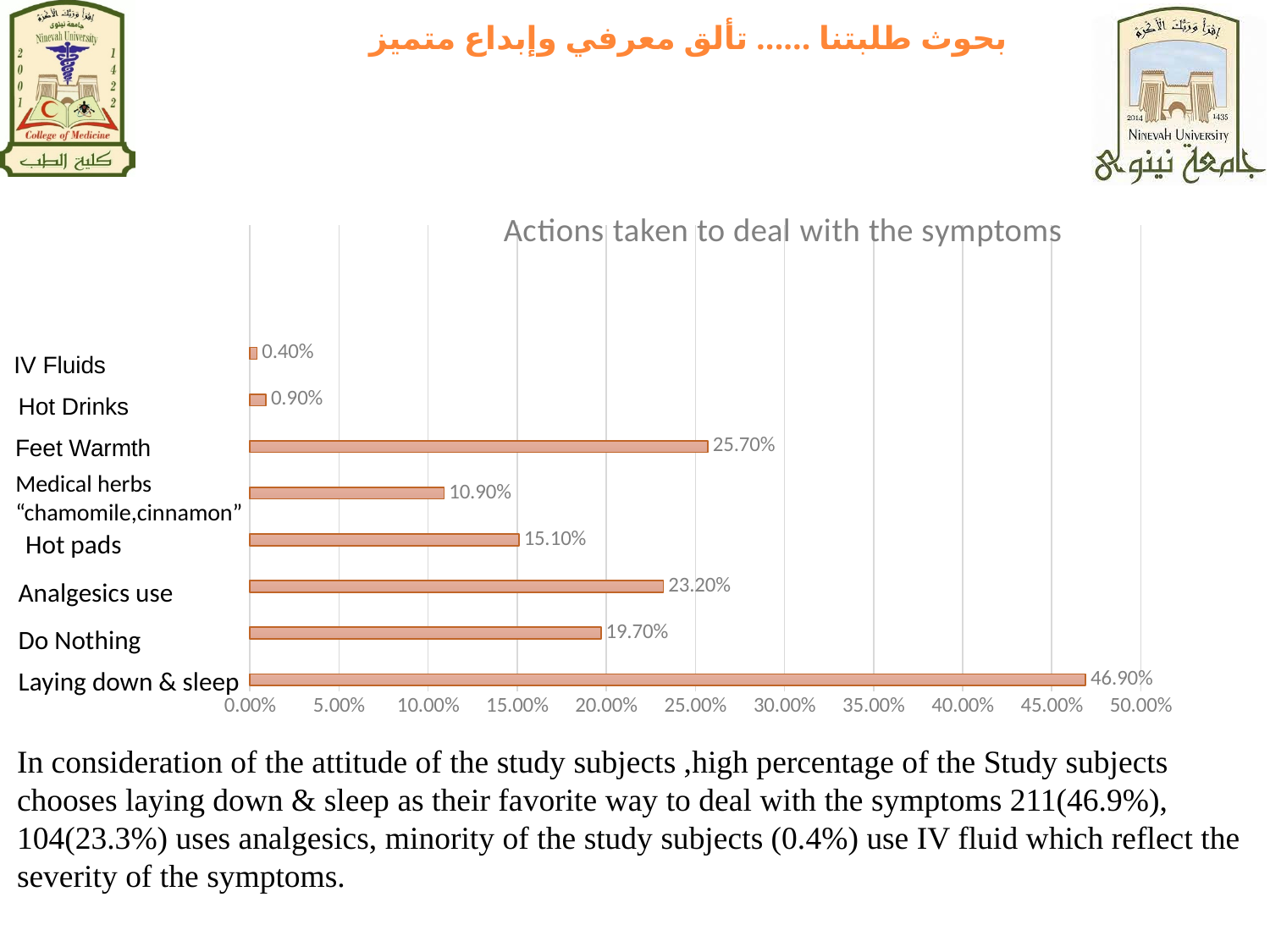
What is the value for Hot pads? 15.10% What kind of chart is shown on the slide? Bar chart How many actions are shown in the chart? 8 Which is larger, the value for Feet Warmth or the value for Analgesics use? Feet Warmth What is the difference between the values for Analgesics use and Do Nothing? 3.50% Is the value for Do Nothing greater or less than 20.00%? less What is the title of the chart? Actions taken to deal with the symptoms Which action has the lowest value? IV Fluids What is the value for Medical herbs "chamomile,cinnamon"? 10.90% Which action has the highest value? Laying down & sleep What is the value for Laying down & sleep? 46.90% What is the value for Feet Warmth? 25.70%